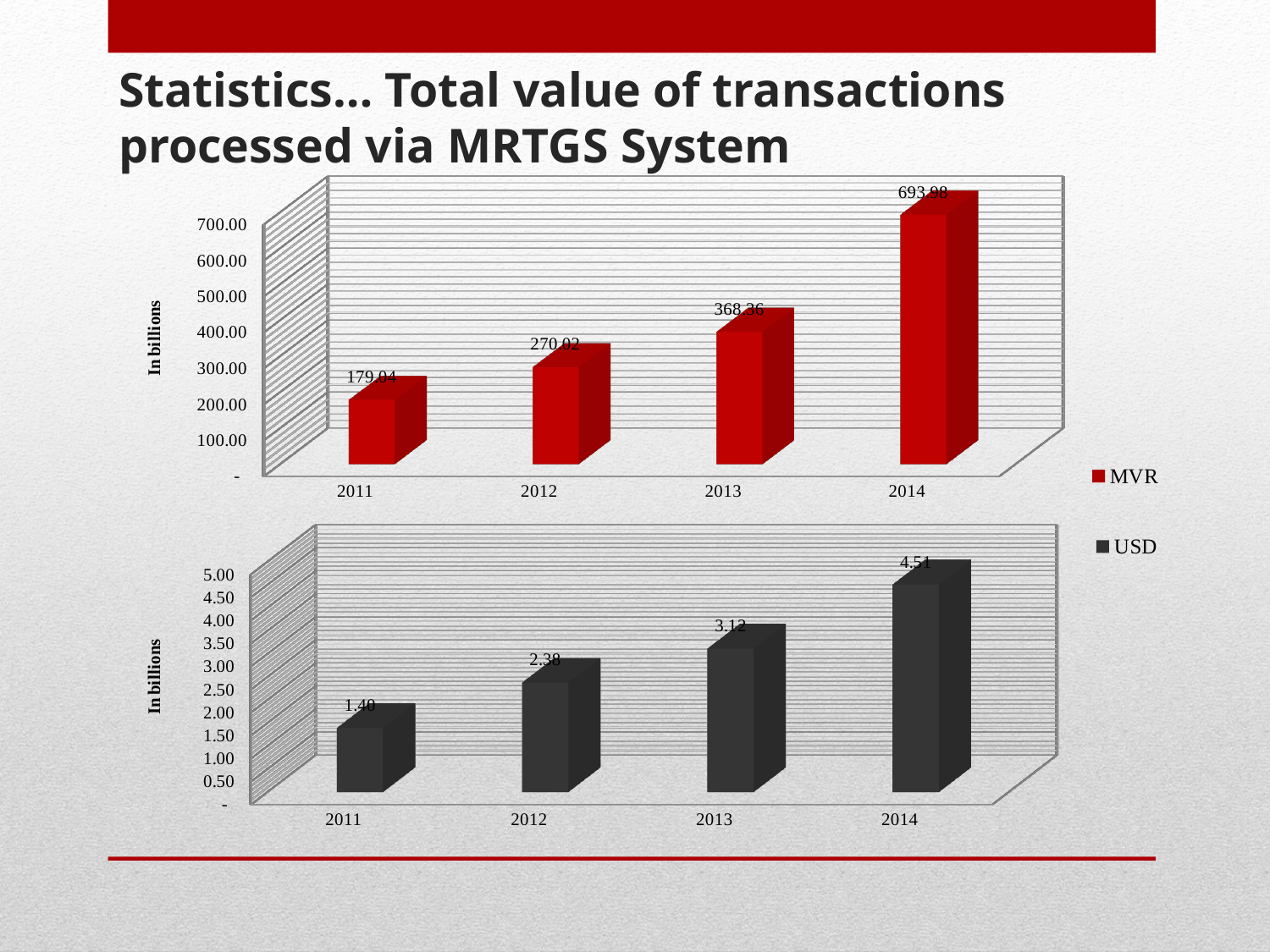
In the top (MVR) chart, which year has the highest value? 2014 In the bottom (USD) chart, what is the value for 2013? 3.12 What kind of chart is the top (MVR) chart? bar chart In the bottom (USD) chart, which year has the lowest value? 2011 In the bottom (USD) chart, what is the difference between the 2014 and 2011 values? 3.11 In the bottom (USD) chart, what is the value for 2012? 2.38 How many years are shown on the x axis of the bottom (USD) chart? 4 In the top (MVR) chart, what is the value for 2014? 693.98 In the top (MVR) chart, what is the difference between the 2013 and 2012 values? 98.34 In the bottom (USD) chart, do the values rise or fall from 2011 to 2014? rise In the top (MVR) chart, is the value for 2013 greater or less than 400.00? less In the top (MVR) chart, what is the value for 2011? 179.04